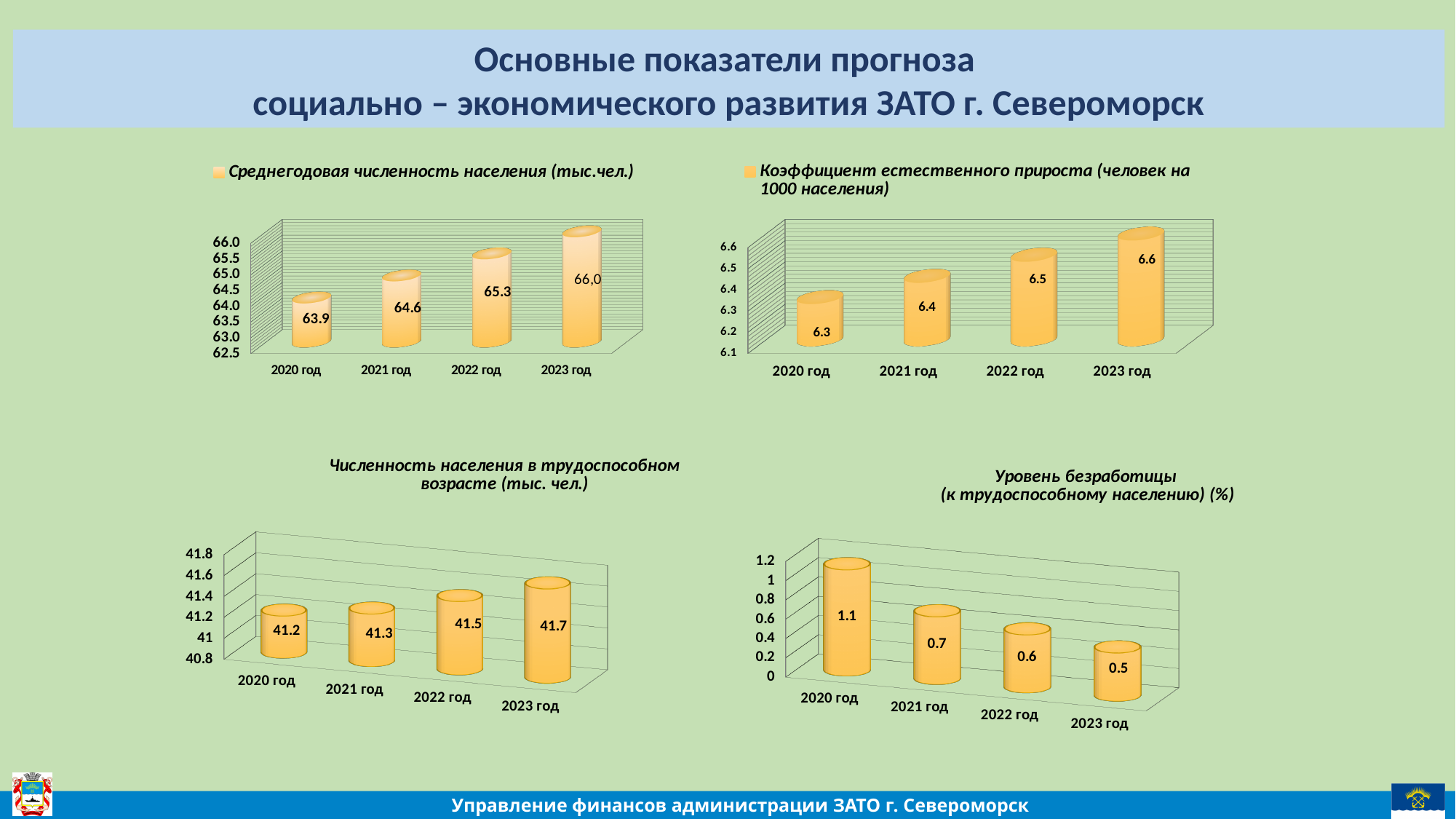
In the top-left chart (Среднегодовая численность населения), do the values rise or fall from 2020 год to 2023 год? rise In the top-left chart (Среднегодовая численность населения), what is the value for 2023 год? 66,0 How many years (categories) are shown in the top-right chart (Коэффициент естественного прироста)? 4 In the top-right chart (Коэффициент естественного прироста), what is the value for 2022 год? 6.5 In the bottom-left chart (Численность населения в трудоспособном возрасте), what is the value for 2022 год? 41.5 In the top-right chart (Коэффициент естественного прироста), which year has the lowest value? 2020 год What type of chart is the bottom-left chart (Численность населения в трудоспособном возрасте)? bar chart In the bottom-right chart (Уровень безработицы), which year has the highest value? 2020 год In the bottom-right chart (Уровень безработицы), what is the value for 2020 год? 1.1 In the bottom-left chart (Численность населения в трудоспособном возрасте), what is the difference between the 2023 год and 2020 год values? 0.5 In the bottom-right chart (Уровень безработицы), do the values rise or fall from 2020 год to 2023 год? fall In the top-left chart (Среднегодовая численность населения), what is the value for 2021 год? 64.6